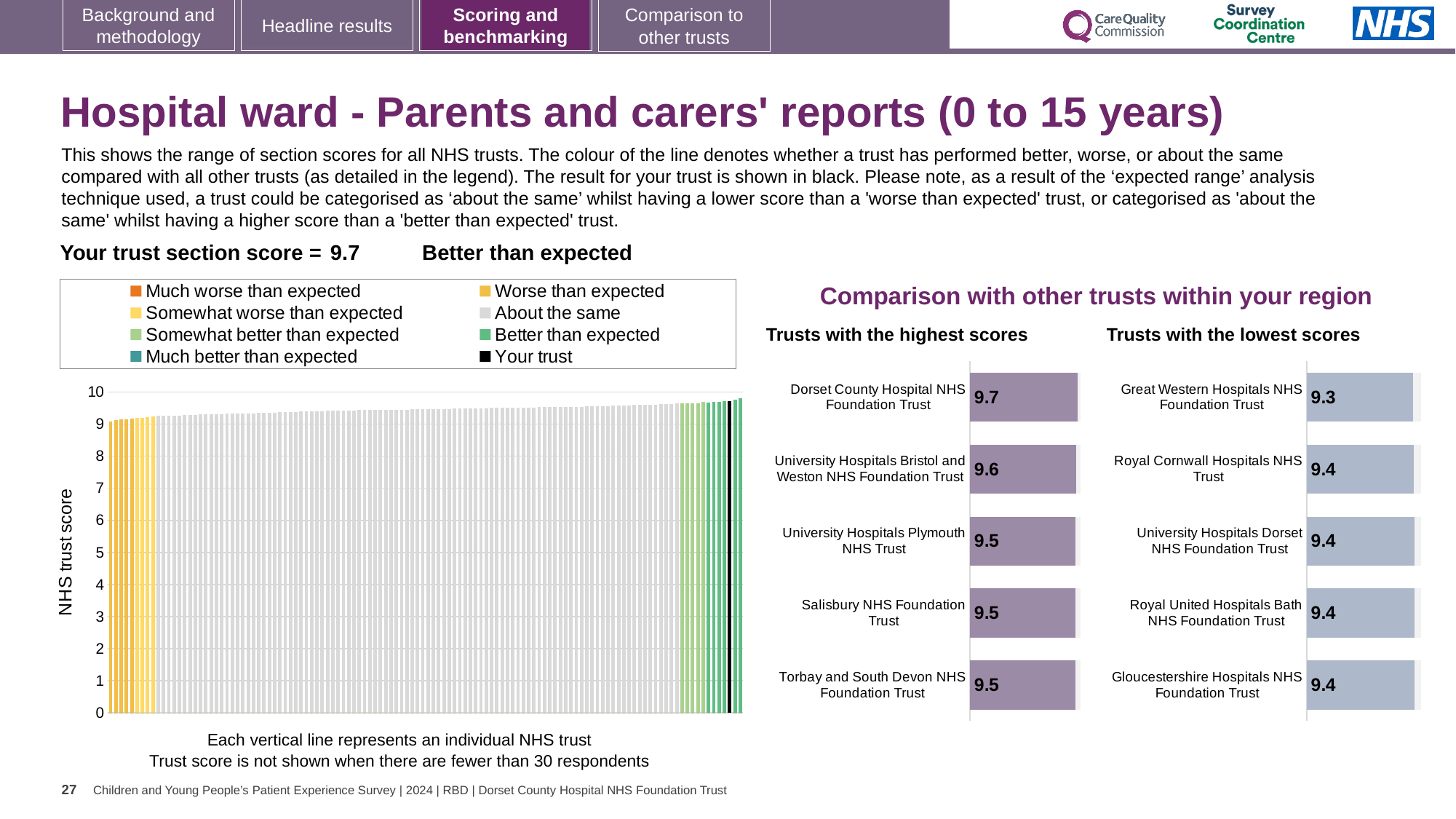
In the 'Trusts with the highest scores' chart, what is the score for University Hospitals Bristol and Weston NHS Foundation Trust? 9.6 In the 'Trusts with the highest scores' chart, what is the difference between the scores of Dorset County Hospital NHS Foundation Trust and University Hospitals Bristol and Weston NHS Foundation Trust? 0.1 In the left-hand NHS trust score chart, is the value for the black 'Your trust' bar greater or less than 8? greater In the 'Trusts with the lowest scores' chart, what is the score for Great Western Hospitals NHS Foundation Trust? 9.3 In the 'Trusts with the highest scores' chart, what is the score for Dorset County Hospital NHS Foundation Trust? 9.7 In the 'Trusts with the highest scores' chart, which trust has the highest score? Dorset County Hospital NHS Foundation Trust How many entries does the legend of the left-hand NHS trust score chart list? 8 Which is larger: the score for Salisbury NHS Foundation Trust in the 'Trusts with the highest scores' chart or the score for Gloucestershire Hospitals NHS Foundation Trust in the 'Trusts with the lowest scores' chart? Salisbury NHS Foundation Trust What kind of chart is the left-hand chart showing NHS trust scores? Bar chart In the 'Trusts with the lowest scores' chart, which trust has the lowest score? Great Western Hospitals NHS Foundation Trust How many trusts are listed in the 'Trusts with the highest scores' chart? 5 In the 'Trusts with the lowest scores' chart, what is the score for Royal Cornwall Hospitals NHS Trust? 9.4